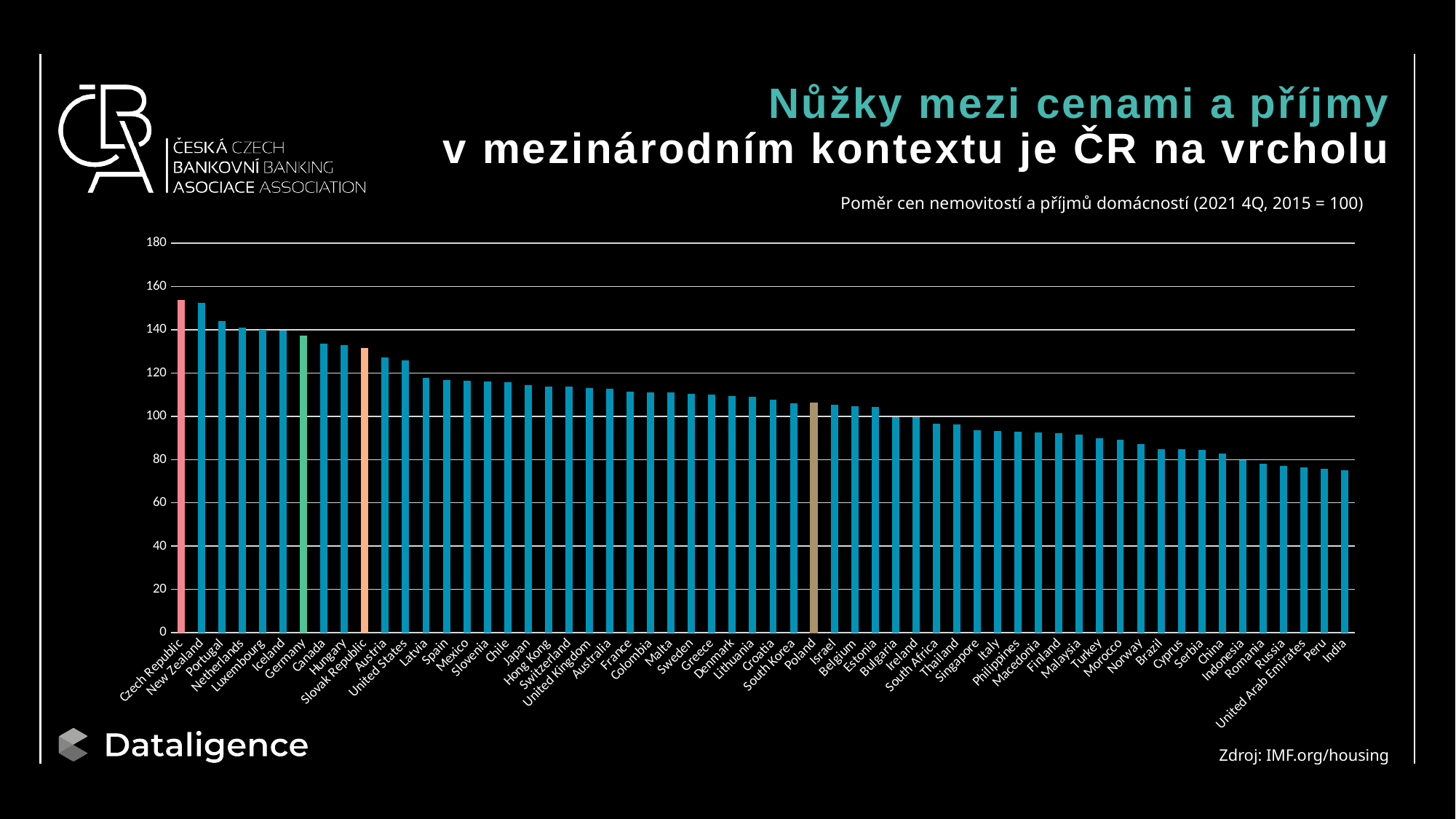
Is the value for Czech Republic greater or less than 140? greater Which country has the highest value in the chart? Czech Republic Is the value for Germany greater or less than 120? greater Do the values rise or fall moving from left to right along the x axis? fall What kind of chart is shown on the slide? bar chart Which has a larger value, Czech Republic or Poland? Czech Republic Is the value for India greater or less than 80? less Which has a larger value, Germany or India? Germany What is the subtitle describing the data plotted in the chart? Poměr cen nemovitostí a příjmů domácností (2021 4Q, 2015 = 100)